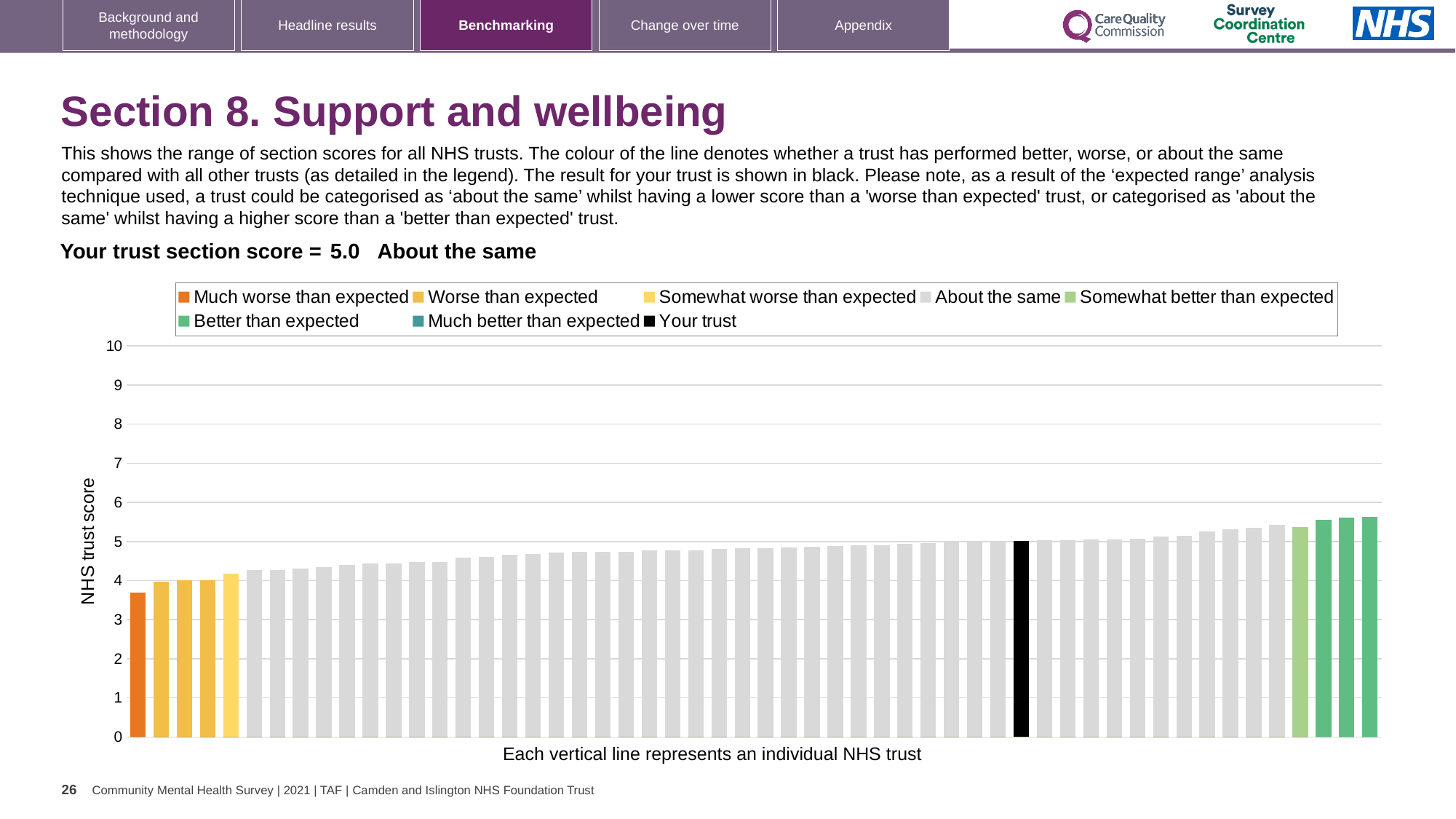
What is the highest value shown on the vertical axis? 10 Do the bar values rise or fall from left to right along the x axis? rise What kind of chart is shown on the slide? bar chart How many bars are coloured as 'Much worse than expected'? 1 Which category is your trust placed in for this section? About the same How many bars are coloured as 'Better than expected'? 3 How many entries does the chart legend list? 8 What is the section score for your trust shown on the slide? 5.0 Is the value of the tallest bar greater or less than 5? greater What is the label on the vertical axis of the chart? NHS trust score Which legend category does the tallest bar belong to? Better than expected Is the value of the 'Much worse than expected' bar greater or less than 4? less